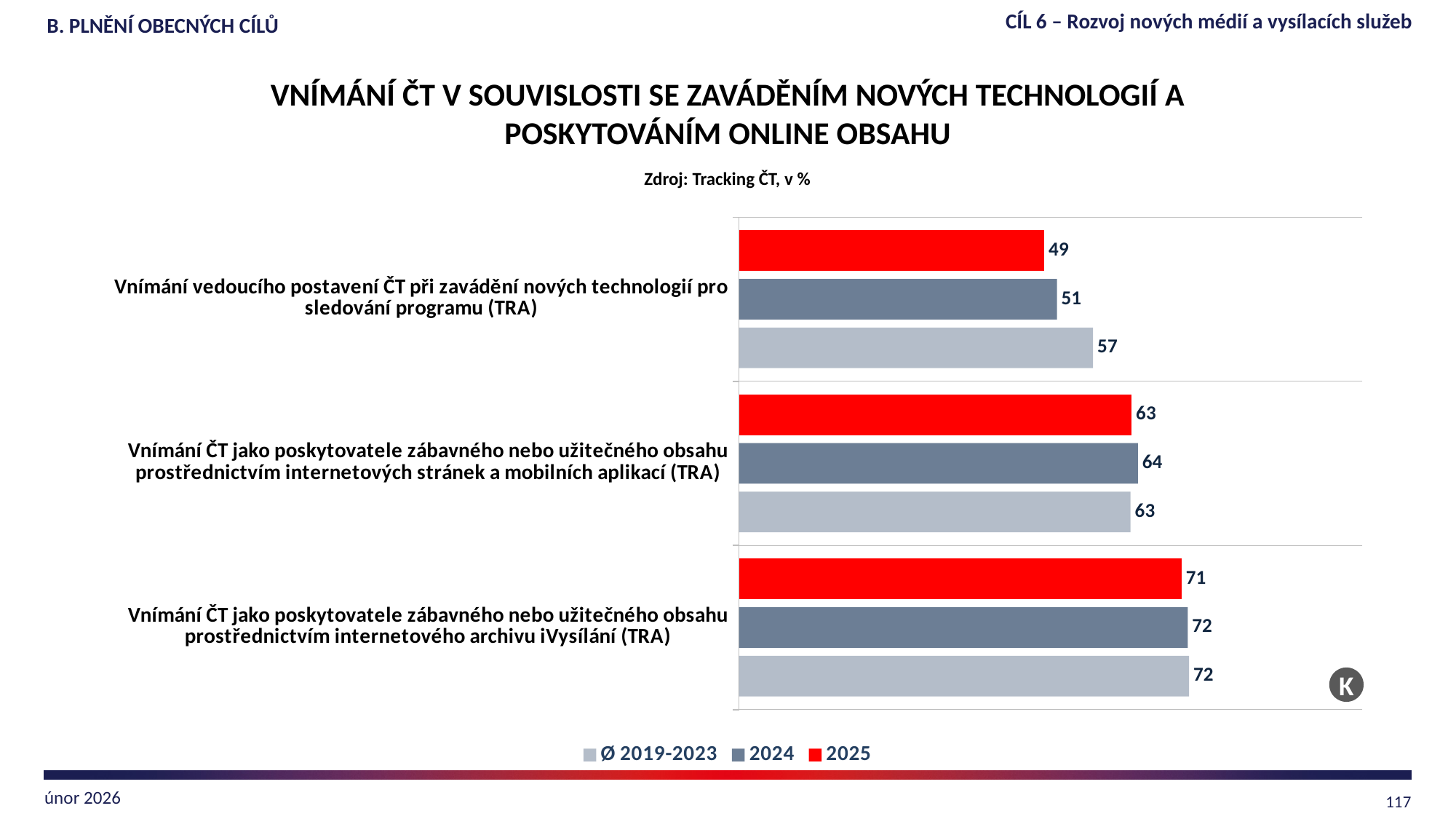
For 'Vnímání ČT jako poskytovatele zábavného nebo užitečného obsahu prostřednictvím internetového archivu iVysílání (TRA)', which is larger: the 2024 value or the 2025 value? 2024 How many series does the legend list? 3 What is the difference between the Ø 2019-2023 value and the 2025 value for 'Vnímání vedoucího postavení ČT při zavádění nových technologií pro sledování programu (TRA)'? 8 What source is cited below the chart title? Tracking ČT, v % What is the 2025 value for 'Vnímání ČT jako poskytovatele zábavného nebo užitečného obsahu prostřednictvím internetového archivu iVysílání (TRA)'? 71 What is the 2025 value for 'Vnímání vedoucího postavení ČT při zavádění nových technologií pro sledování programu (TRA)'? 49 What type of chart is shown on the slide? bar chart Which category has the lowest 2024 value? Vnímání vedoucího postavení ČT při zavádění nových technologií pro sledování programu (TRA) What is the 2024 value for 'Vnímání ČT jako poskytovatele zábavného nebo užitečného obsahu prostřednictvím internetových stránek a mobilních aplikací (TRA)'? 64 How many categories are shown in the chart? 3 Which category has the highest 2025 value? Vnímání ČT jako poskytovatele zábavného nebo užitečného obsahu prostřednictvím internetového archivu iVysílání (TRA) What is the Ø 2019-2023 value for 'Vnímání vedoucího postavení ČT při zavádění nových technologií pro sledování programu (TRA)'? 57